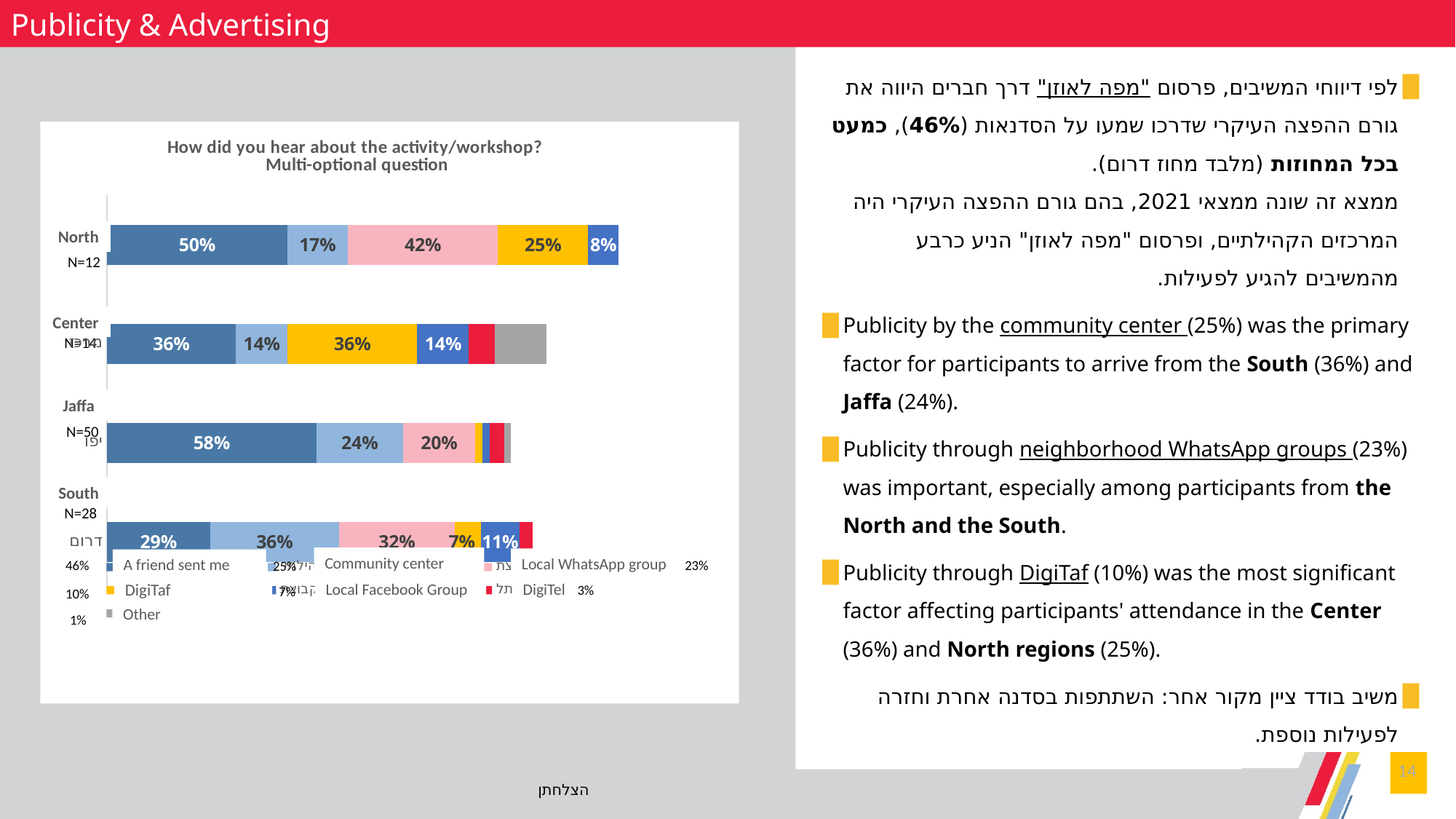
Which region has the highest value for "A friend sent me"? Jaffa What is the value for Local WhatsApp group in the North region? 42% What is the difference between the "A friend sent me" values for Jaffa and South? 29% How many series does the chart legend list? 7 What is the value for Local Facebook Group in the South region? 11% What is the value for DigiTaf in the Center region? 36% Which is larger: the Community center value for South or for North? South What is the value for Community center in the Jaffa region? 24% What is the title of the chart? How did you hear about the activity/workshop? Multi-optional question What type of chart is shown on the slide? Stacked bar chart How many regions (categories) are plotted in the chart? 4 What percentage of North respondents heard about the activity from a friend ("A friend sent me")? 50%